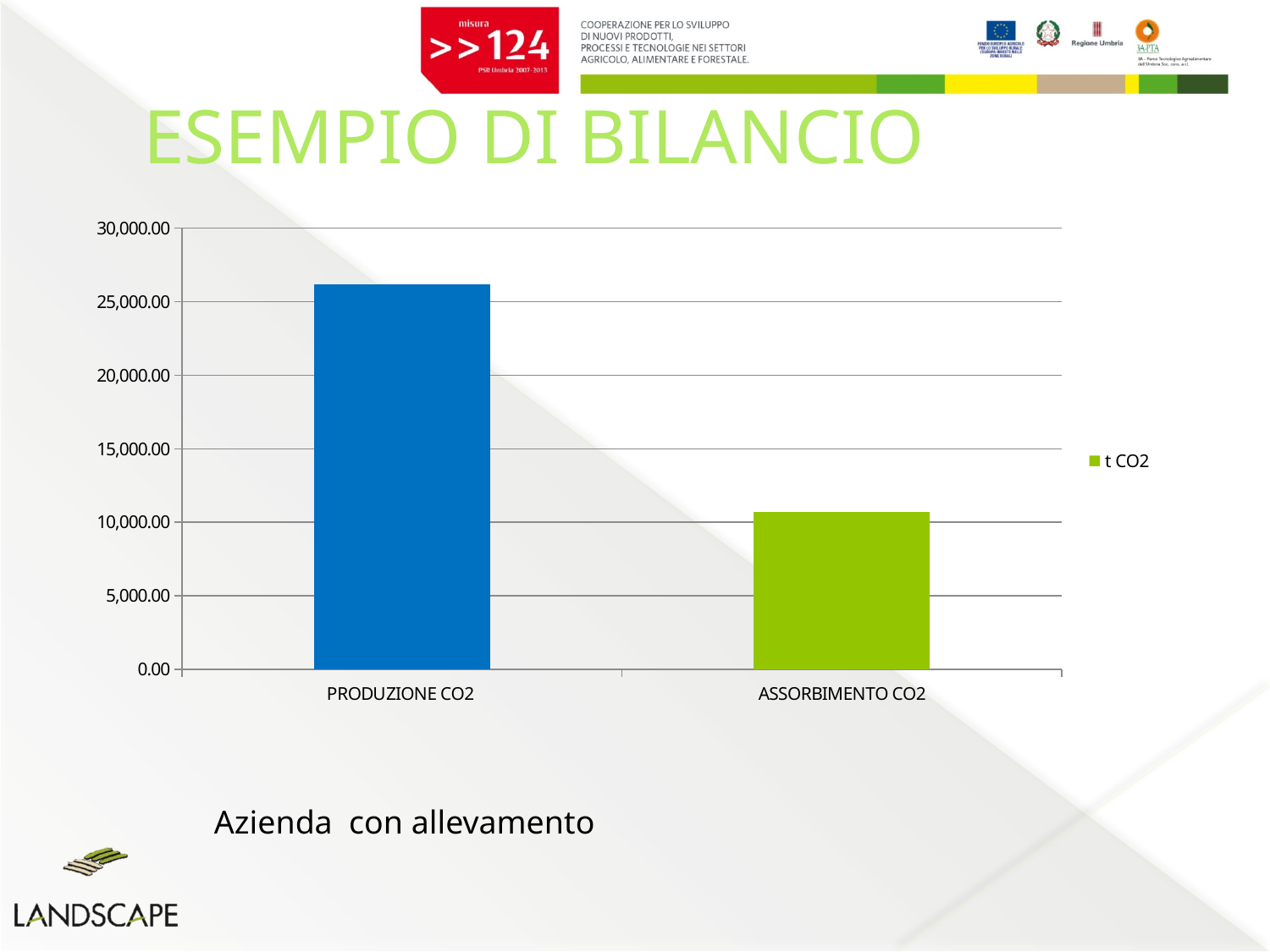
How many series does the chart legend list? 1 Which category has the highest value in the chart? PRODUZIONE CO2 Do the values rise or fall from left to right along the x axis? fall Which category has the lowest value in the chart? ASSORBIMENTO CO2 Which is larger, the value for PRODUZIONE CO2 or the value for ASSORBIMENTO CO2? PRODUZIONE CO2 Is the value for ASSORBIMENTO CO2 greater or less than 10,000.00? greater Is the value for PRODUZIONE CO2 greater or less than 30,000.00? less Is the value for PRODUZIONE CO2 greater or less than 25,000.00? greater How many categories are plotted on the x axis of the chart? 2 What series name is shown in the chart legend? t CO2 What kind of chart is shown on the slide? bar chart